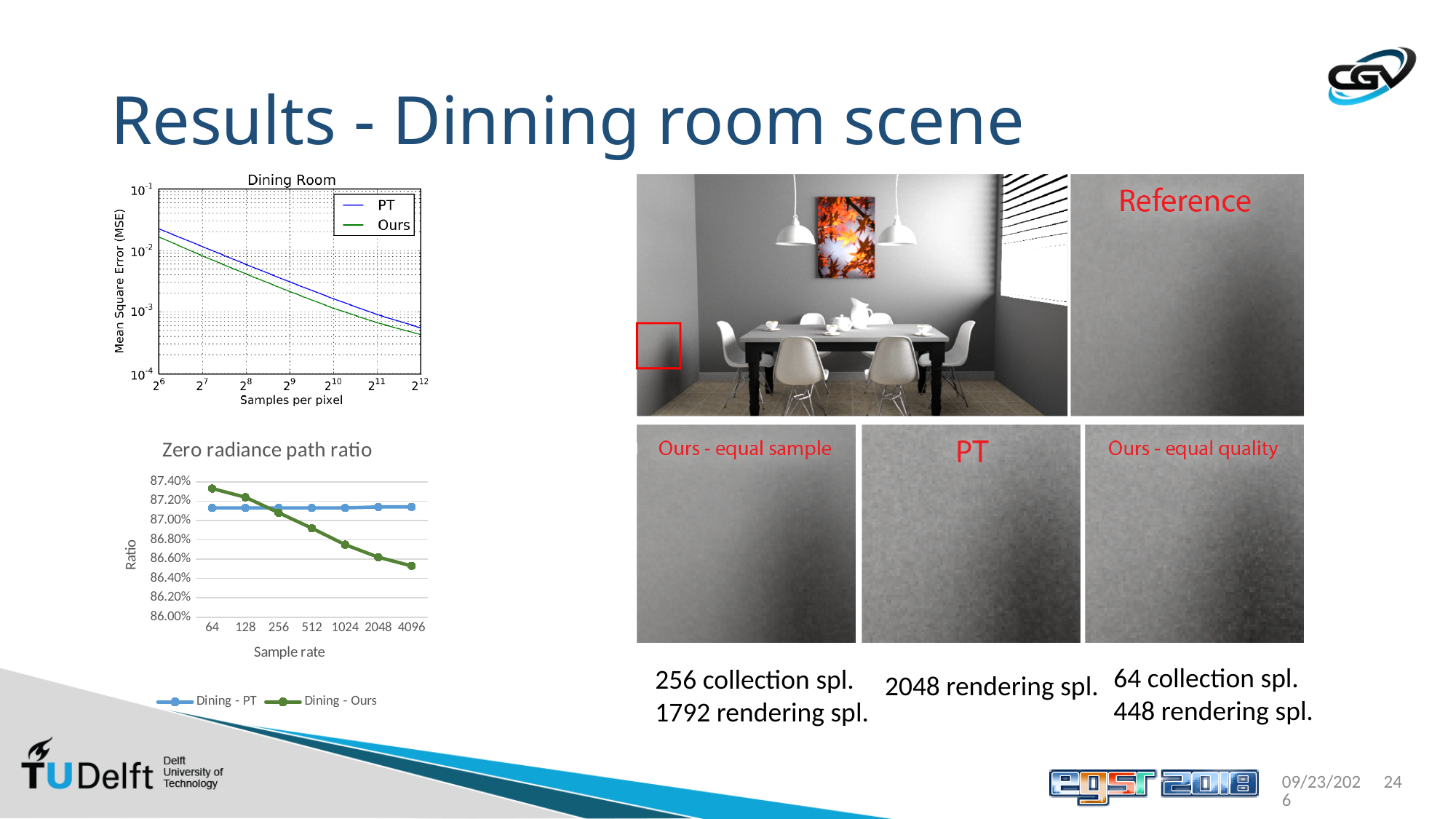
In the 'Dining Room' chart, is the value for Ours at 2^12 samples per pixel greater or less than 10^-3? less In the 'Zero radiance path ratio' chart, what is the label of the y axis? Ratio How many series does the legend of the 'Zero radiance path ratio' chart list? 2 In the 'Zero radiance path ratio' chart, does the 'Dining - Ours' series rise or fall as the sample rate increases? fall In the 'Dining Room' chart, which series has the higher mean square error across the samples per pixel range, PT or Ours? PT In the 'Dining Room' chart, does the mean square error rise or fall as samples per pixel increase? fall In the 'Zero radiance path ratio' chart, is the value for 'Dining - Ours' at sample rate 64 greater or less than 87.20%? greater What kind of chart is the 'Zero radiance path ratio' chart? line chart In the 'Zero radiance path ratio' chart, which series is higher at a sample rate of 64, 'Dining - PT' or 'Dining - Ours'? Dining - Ours In the 'Zero radiance path ratio' chart, is the value for 'Dining - Ours' at sample rate 1024 greater or less than 87.00%? less In the 'Zero radiance path ratio' chart, which series is higher at a sample rate of 4096, 'Dining - PT' or 'Dining - Ours'? Dining - PT In the 'Zero radiance path ratio' chart, how many sample rate categories are shown on the x axis? 7